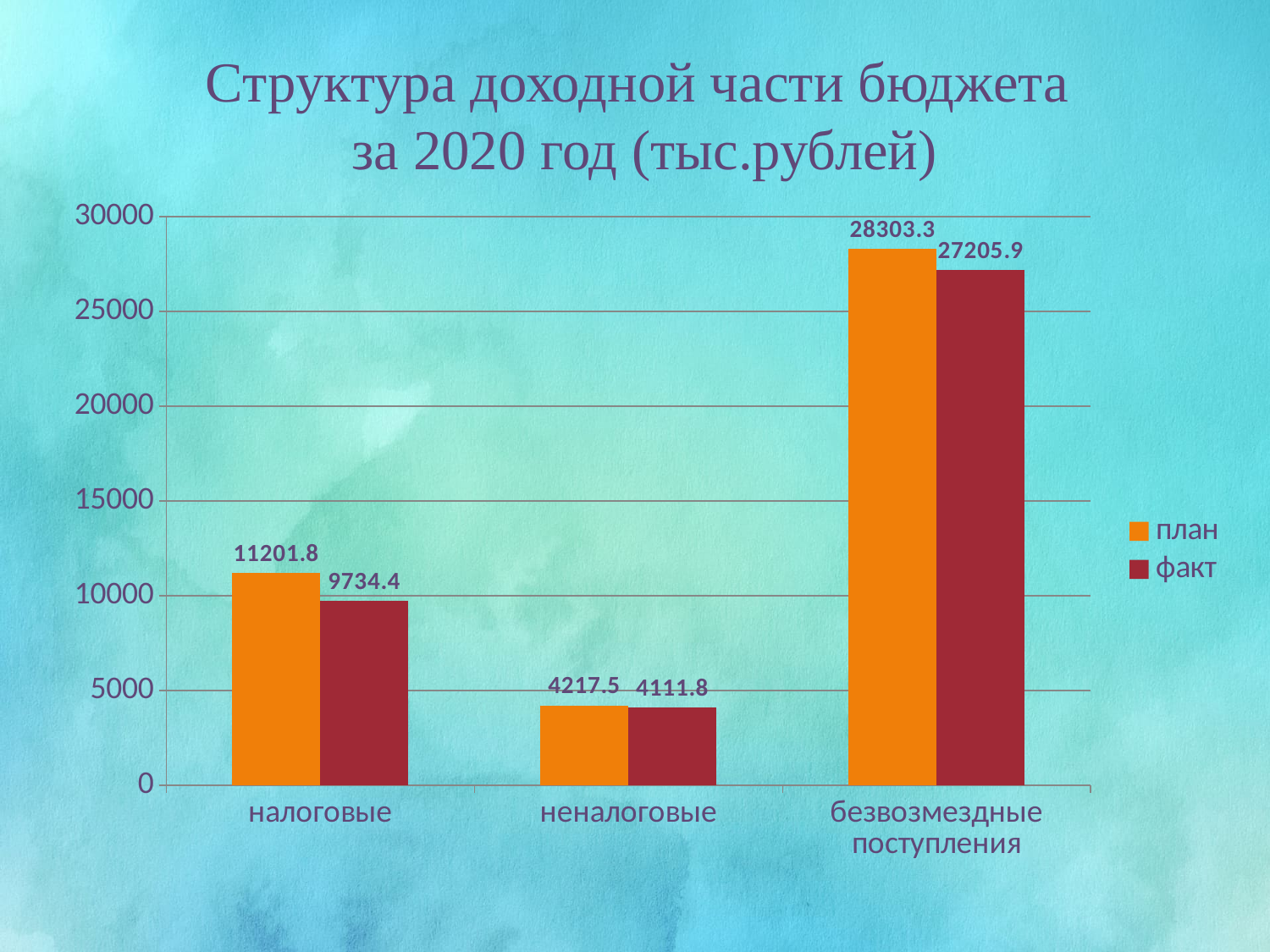
Is the факт value for безвозмездные поступления greater or less than 25000? greater What is the difference between the план and факт values for безвозмездные поступления? 1097.4 How many categories are shown on the x axis? 3 Which category has the lowest факт value? неналоговые What is the difference between the план and факт values for налоговые? 1467.4 What is the факт value for неналоговые? 4111.8 What is the факт value for безвозмездные поступления? 27205.9 How many series does the legend list? 2 Which category has the highest план value? безвозмездные поступления What is the план value for налоговые? 11201.8 What kind of chart is shown on the slide? bar chart Which is larger for налоговые, the план value or the факт value? план